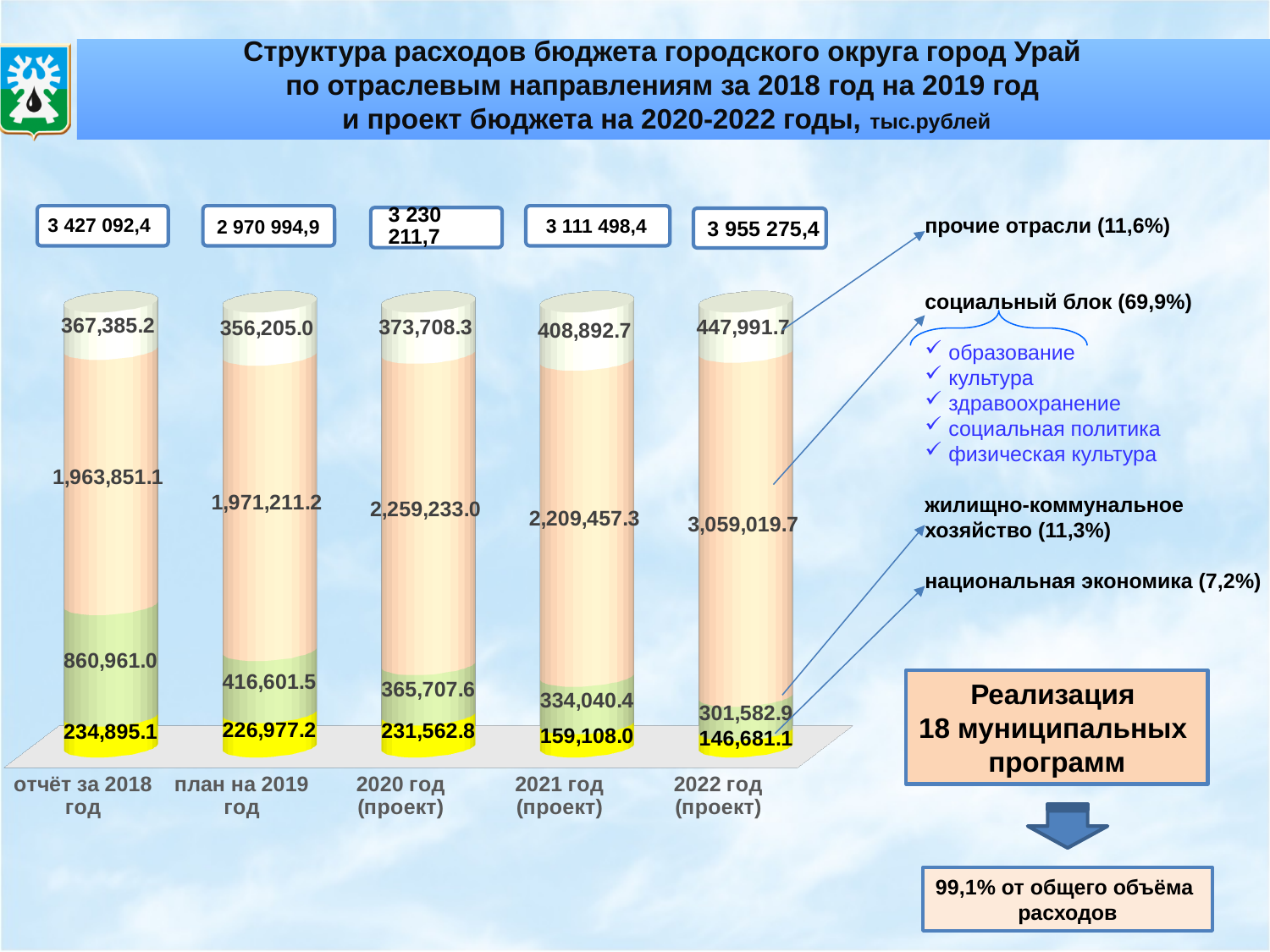
Which is larger: the top segment value for 2020 год (проект) or for план на 2019 год? 2020 год (проект) What is the value of the социальный блок segment for 2022 год (проект)? 3,059,019.7 What is the value of the green segment (жилищно-коммунальное хозяйство) for план на 2019 год? 416,601.5 Which year has the highest value for the социальный блок segment? 2022 год (проект) What is the value of the bottom (yellow) segment for отчёт за 2018 год? 234,895.1 What is the total shown above the bar for 2022 год (проект)? 3 955 275,4 How many categories (years) are shown along the x axis of the chart? 5 What is the difference between the green segment values for отчёт за 2018 год and план на 2019 год? 444,359.5 Which year has the lowest value for the bottom (yellow) segment? 2022 год (проект) What is the value of the top segment (прочие отрасли) for 2021 год (проект)? 408,892.7 What type of chart is shown on the slide? stacked bar chart Do the values of the top segment (прочие отрасли) rise or fall from план на 2019 год to 2022 год (проект)? rise